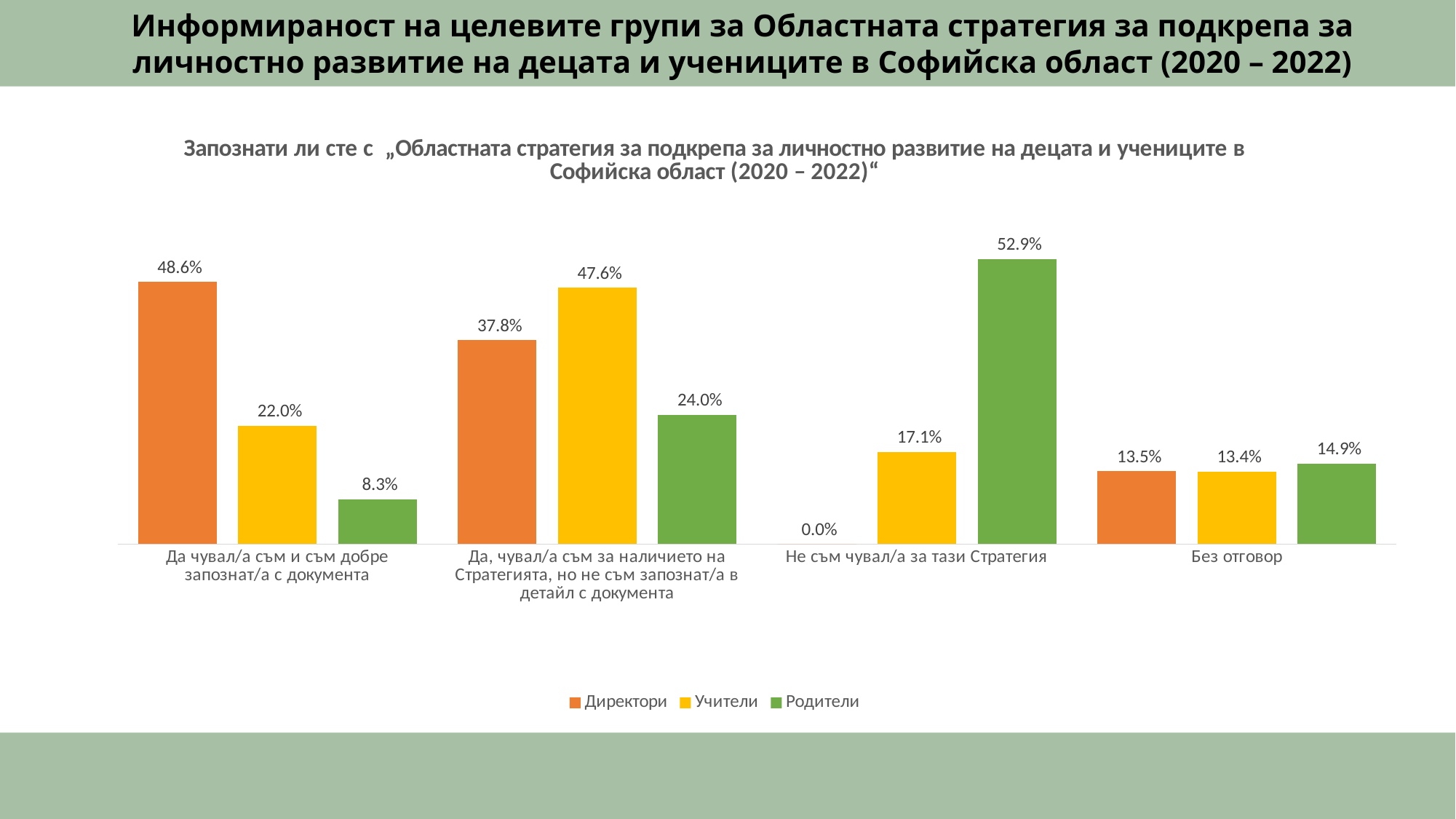
What is the difference between the Директори and Родители values in the category „Да чувал/а съм и съм добре запознат/а с документа“? 40.3% How many series does the legend list? 3 Which colour represents the Учители series in the legend? Yellow What is the value for Учители in the category „Да, чувал/а съм за наличието на Стратегията, но не съм запознат/а в детайл с документа“? 47.6% What kind of chart is shown on the slide? Bar chart What is the value for Родители in the category „Не съм чувал/а за тази Стратегия“? 52.9% How many categories are shown on the x axis? 4 Which is larger in the category „Без отговор“: the value for Директори or for Родители? Родители What is the value for Директори in the category „Да чувал/а съм и съм добре запознат/а с документа“? 48.6% Which category has the highest value for Родители? Не съм чувал/а за тази Стратегия What is the value for Директори in the category „Не съм чувал/а за тази Стратегия“? 0.0% Which category has the lowest value for Директори? Не съм чувал/а за тази Стратегия